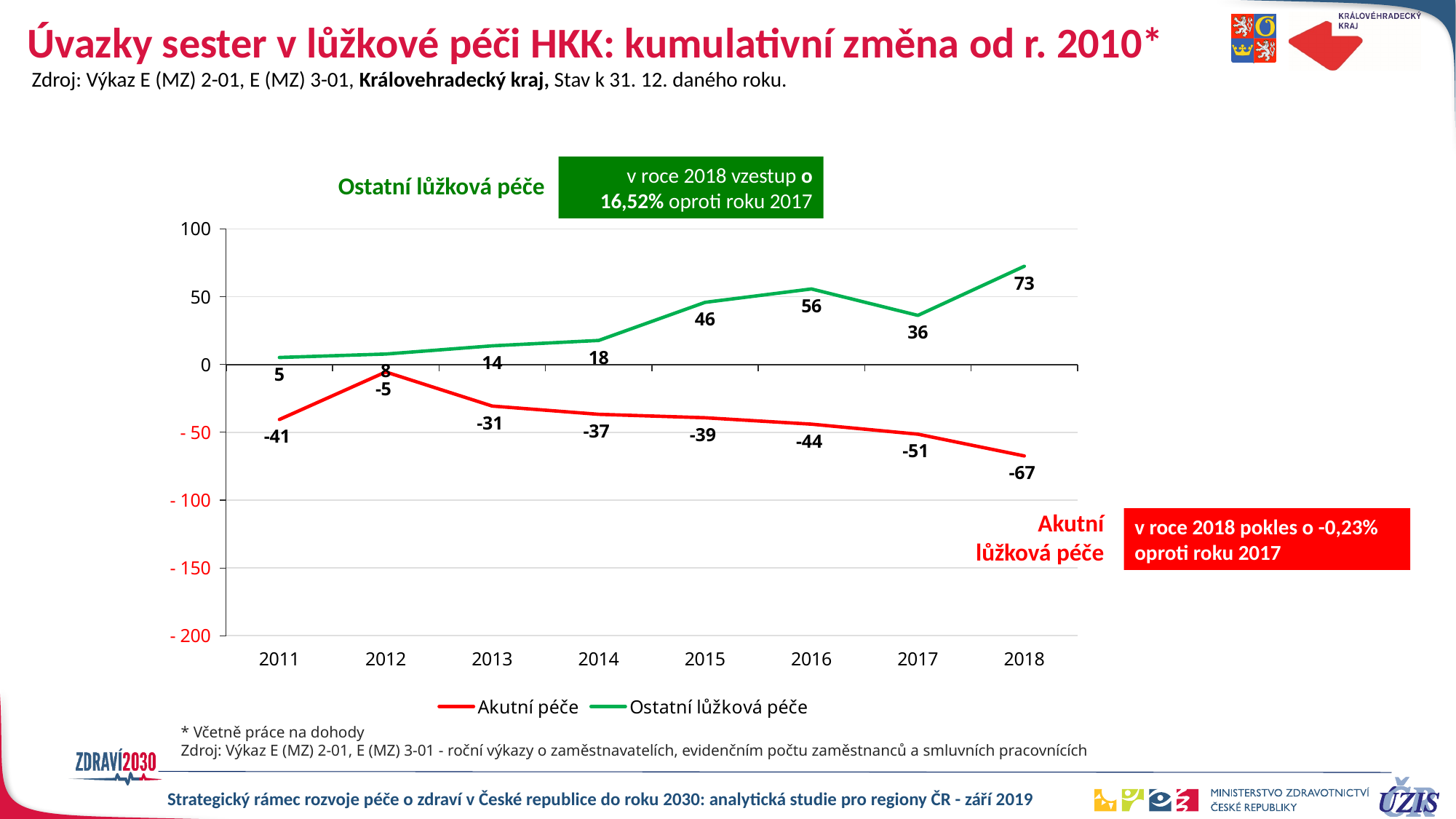
What is the value for Ostatní lůžková péče in 2018? 73 Which series has the larger value in 2015, Akutní péče or Ostatní lůžková péče? Ostatní lůžková péče What is the difference between the Ostatní lůžková péče values in 2016 and 2017? 20 How many series does the legend list? 2 What type of chart is shown on the slide? line chart What is the value for Akutní péče in 2012? -5 How many years are plotted on the x axis? 8 In which year is the value for Akutní péče lowest? 2018 What is the value for Akutní péče in 2018? -67 What colour is the line for Akutní péče? red Does the value for Akutní péče generally rise or fall from 2012 to 2018? fall In which year is the value for Ostatní lůžková péče highest? 2018